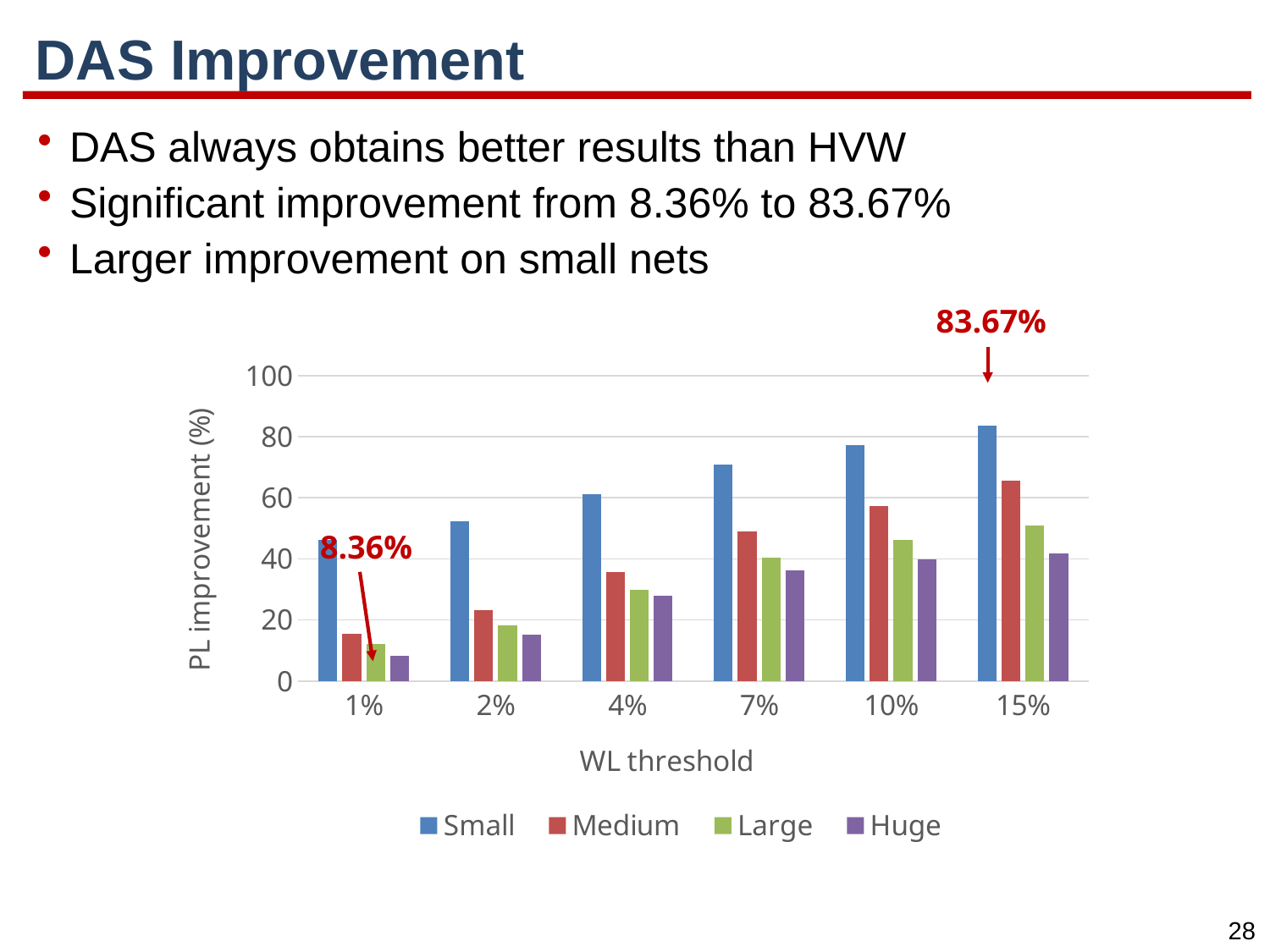
What is the difference between the annotated 83.67% value and the annotated 8.36% value? 75.31% At which WL threshold does the Small series reach its highest value? 15% Does the Small series rise or fall as the WL threshold increases? Rise What kind of chart is shown on the slide? Bar chart Is the value for Small at the 7% WL threshold greater or less than 60? greater How many WL threshold categories are shown on the x axis? 6 At which WL threshold is the Huge series lowest? 1% Is the value for Medium at the 4% WL threshold greater or less than 40? less What value is annotated for the Small series at the 15% WL threshold? 83.67% At the 7% WL threshold, which is larger: Small or Medium? Small How many series does the legend list? 4